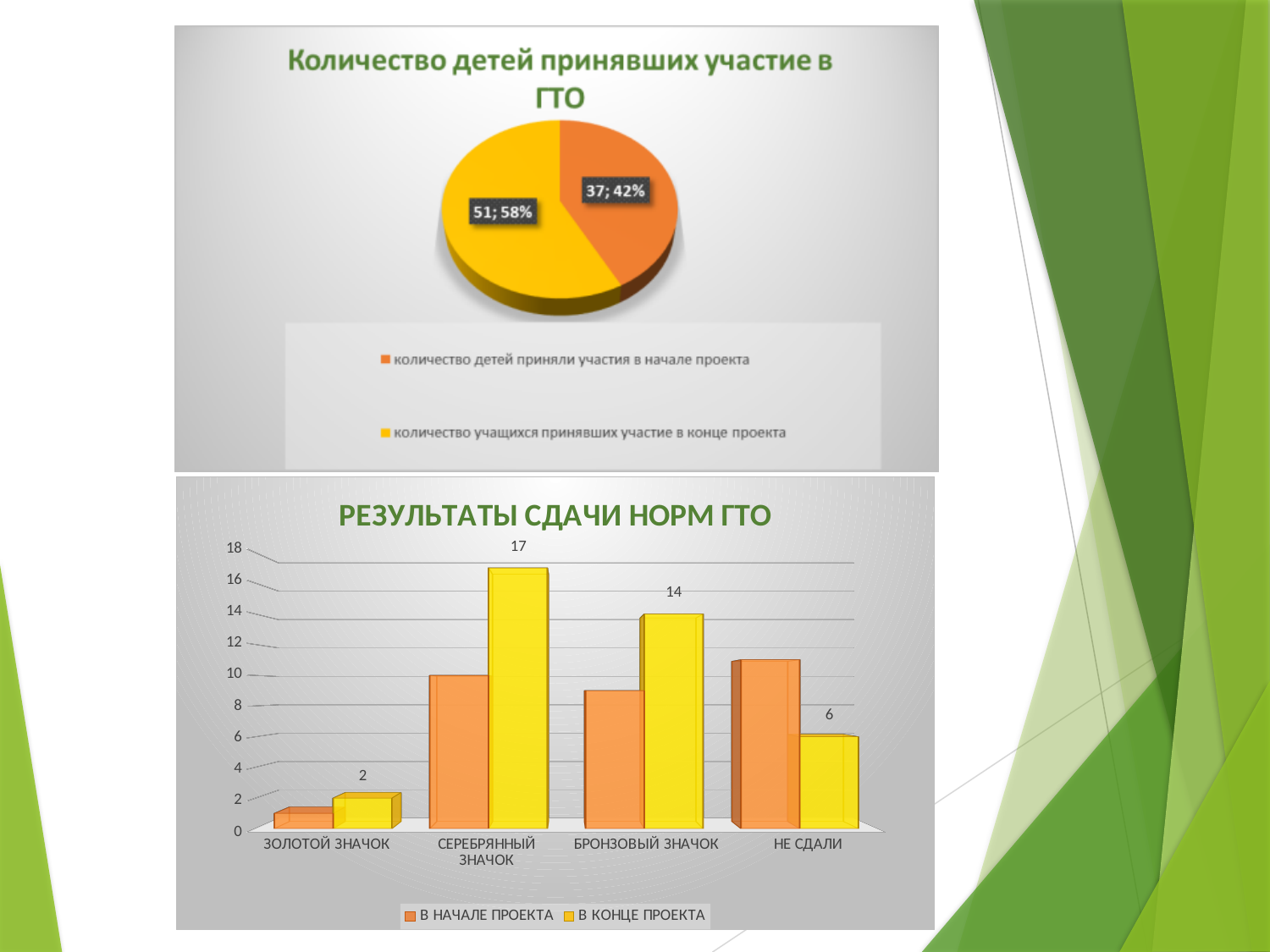
In the bar chart titled "РЕЗУЛЬТАТЫ СДАЧИ НОРМ ГТО", what is the value for "Серебрянный значок" in the series "В конце проекта"? 17 In the bar chart titled "РЕЗУЛЬТАТЫ СДАЧИ НОРМ ГТО", what is the difference between the "В конце проекта" values for "Серебрянный значок" and "Бронзовый значок"? 3 In the bar chart titled "РЕЗУЛЬТАТЫ СДАЧИ НОРМ ГТО", is the value for "Не сдали" in the series "В начале проекта" greater or less than 8? greater In the pie chart titled "Количество детей принявших участие в ГТО", how many slices does the pie have? 2 In the pie chart titled "Количество детей принявших участие в ГТО", which slice is larger: the start of the project or the end of the project? End of the project (51; 58%) In the pie chart titled "Количество детей принявших участие в ГТО", what is the difference between the number of participants at the end and at the start of the project? 14 In the bar chart titled "РЕЗУЛЬТАТЫ СДАЧИ НОРМ ГТО", what is the value for "Не сдали" in the series "В конце проекта"? 6 In the bar chart titled "РЕЗУЛЬТАТЫ СДАЧИ НОРМ ГТО", which category has the lowest value in the series "В конце проекта"? Золотой значок In the pie chart titled "Количество детей принявших участие в ГТО", what value is shown for the number of children who took part at the start of the project? 37 In the pie chart titled "Количество детей принявших участие в ГТО", what percentage share does the slice for students who took part at the end of the project have? 58% In the bar chart titled "РЕЗУЛЬТАТЫ СДАЧИ НОРМ ГТО", which category has the highest value in the series "В конце проекта"? Серебрянный значок In the bar chart titled "РЕЗУЛЬТАТЫ СДАЧИ НОРМ ГТО", how many series does the legend list? 2